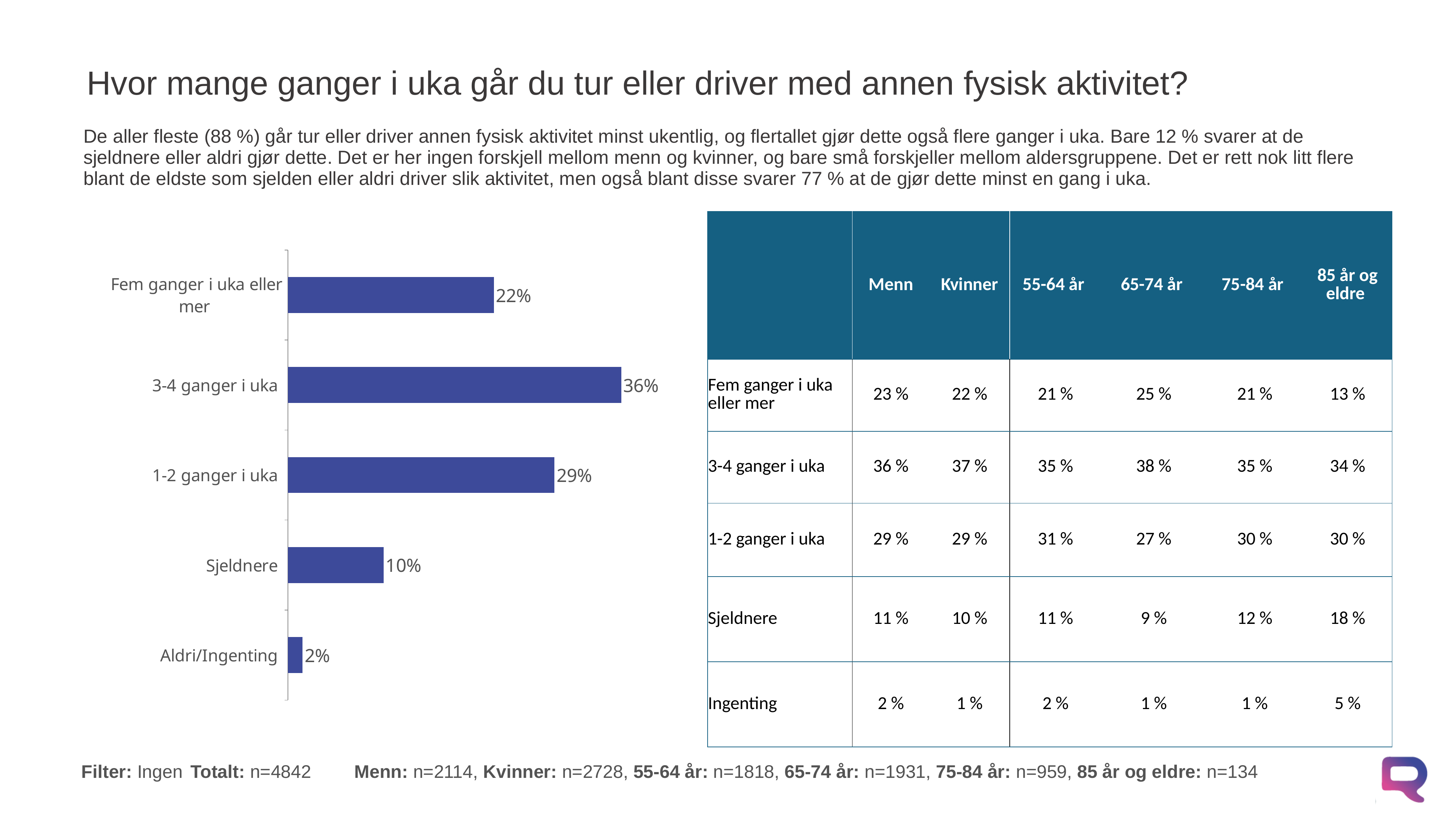
What is the value for "Aldri/Ingenting" in the bar chart? 2% Which is larger in the bar chart: "Fem ganger i uka eller mer" or "1-2 ganger i uka"? 1-2 ganger i uka What is the value for "Sjeldnere" in the bar chart? 10% What is the difference between the values for "Sjeldnere" and "Aldri/Ingenting" in the bar chart? 8% What colour are the bars in the bar chart? Blue How many categories are shown in the bar chart? 5 Which category has the lowest value in the bar chart? Aldri/Ingenting What is the value for "Fem ganger i uka eller mer" in the bar chart? 22% Which category has the highest value in the bar chart? 3-4 ganger i uka What is the difference between the values for "3-4 ganger i uka" and "1-2 ganger i uka" in the bar chart? 7% What is the value for "3-4 ganger i uka" in the bar chart? 36% What kind of chart is shown on the slide? Bar chart